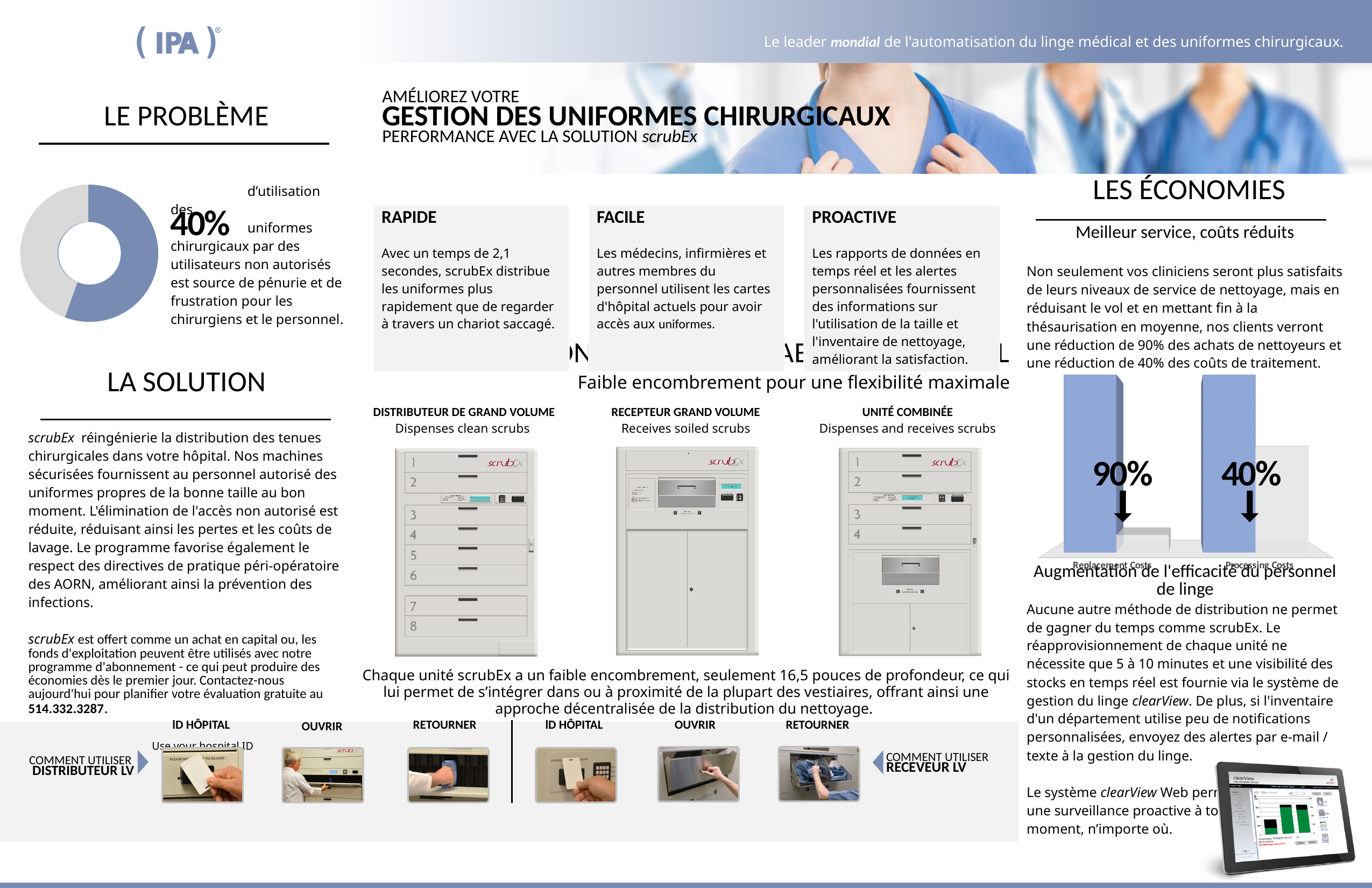
What kind of chart is shown under the LES ÉCONOMIES heading? Bar chart On the donut chart under LE PROBLÈME, how many slices are there? 2 On the bar chart under LES ÉCONOMIES, what are the two category labels on the x axis? Replacement Costs and Processing Costs On the bar chart under LES ÉCONOMIES, how many categories are shown on the x axis? 2 On the bar chart under LES ÉCONOMIES, which category shows the larger percentage reduction, Replacement Costs or Processing Costs? Replacement Costs On the bar chart under LES ÉCONOMIES, what percentage is printed on the Processing Costs bar? 40% On the donut chart under LE PROBLÈME, is the blue slice larger or smaller than the grey slice? Larger On the donut chart under LE PROBLÈME, what percentage is printed next to the chart? 40% On the bar chart under LES ÉCONOMIES, what is the difference between the percentages printed for Replacement Costs and Processing Costs? 50% What kind of chart is shown under the LE PROBLÈME heading? Donut (pie) chart On the bar chart under LES ÉCONOMIES, what percentage is printed on the Replacement Costs bar? 90%